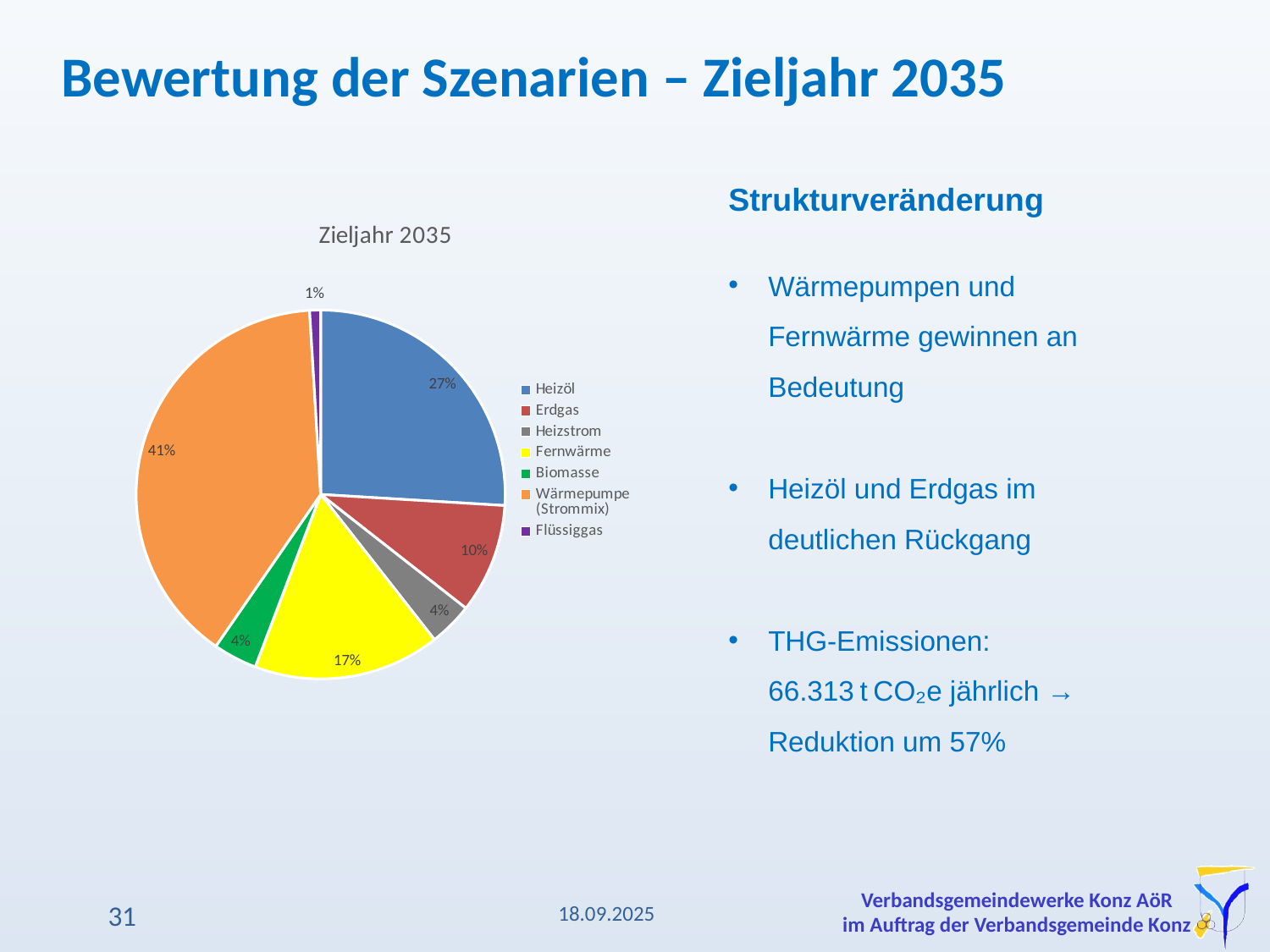
What share of the pie does Flüssiggas have? 1% What share of the pie does Fernwärme have? 17% What share of the pie does Heizöl have? 27% How many categories does the legend list? 7 What kind of chart is shown on the slide? pie chart Which category has the largest slice of the pie? Wärmepumpe (Strommix) What is the title of the chart? Zieljahr 2035 Which slice is larger, Fernwärme or Erdgas? Fernwärme Which category has the smallest slice of the pie? Flüssiggas What is the difference in percentage points between the Heizöl slice and the Erdgas slice? 17